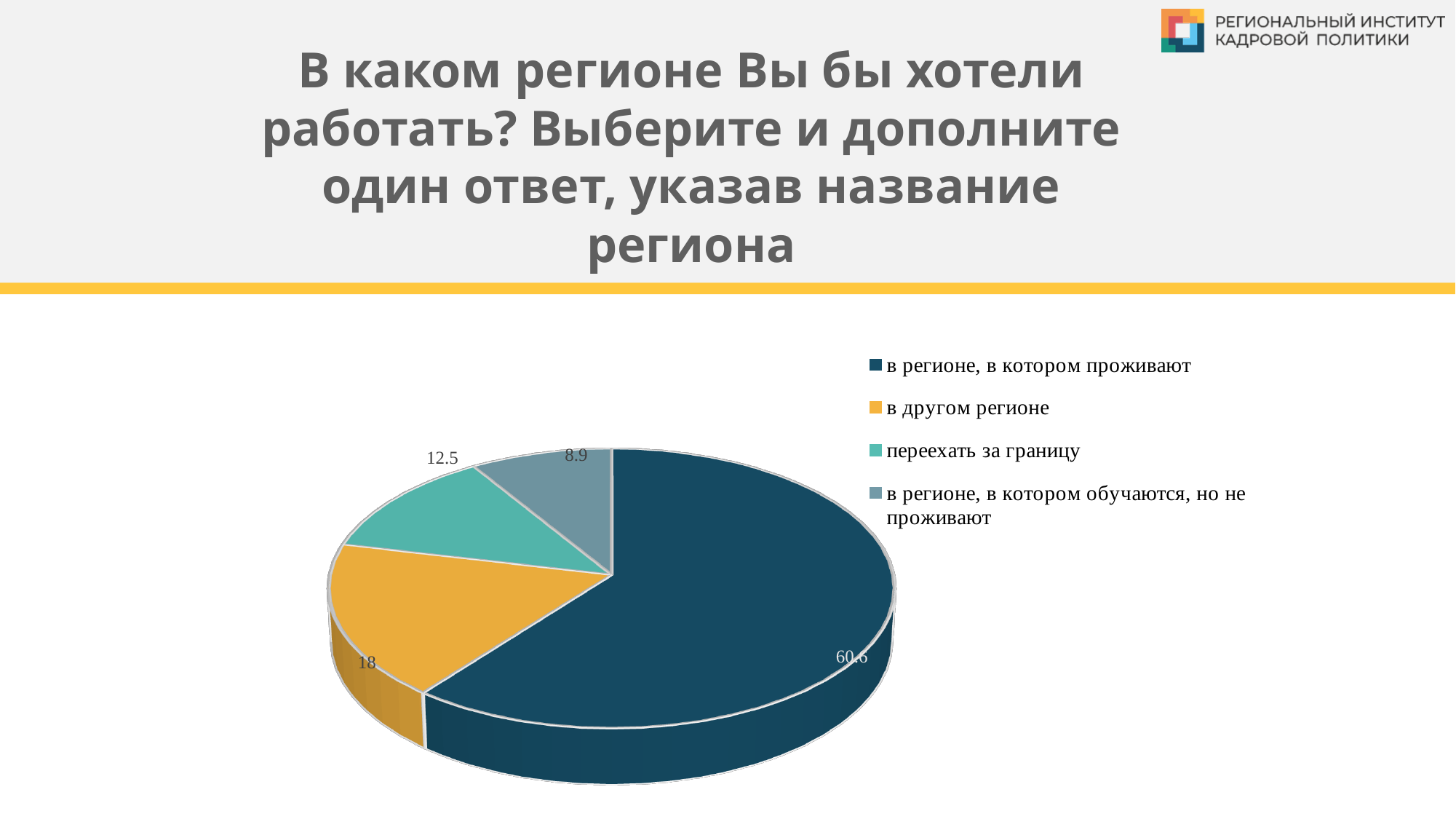
Which category has the largest slice of the pie? в регионе, в котором проживают Which is larger: the slice for "в другом регионе" or the slice for "переехать за границу"? в другом регионе What value is shown for the slice "переехать за границу"? 12.5 What value is shown for the slice "в регионе, в котором проживают"? 60.6 What value is shown for the slice "в другом регионе"? 18 What colour is the slice for "переехать за границу"? teal (green) What kind of chart is shown on the slide? pie chart How many slices does the pie chart have? 4 What value is shown for the slice "в регионе, в котором обучаются, но не проживают"? 8.9 What is the difference between the values for "переехать за границу" and "в регионе, в котором обучаются, но не проживают"? 3.6 Which category has the smallest slice of the pie? в регионе, в котором обучаются, но не проживают What is the difference between the values for "в другом регионе" and "переехать за границу"? 5.5